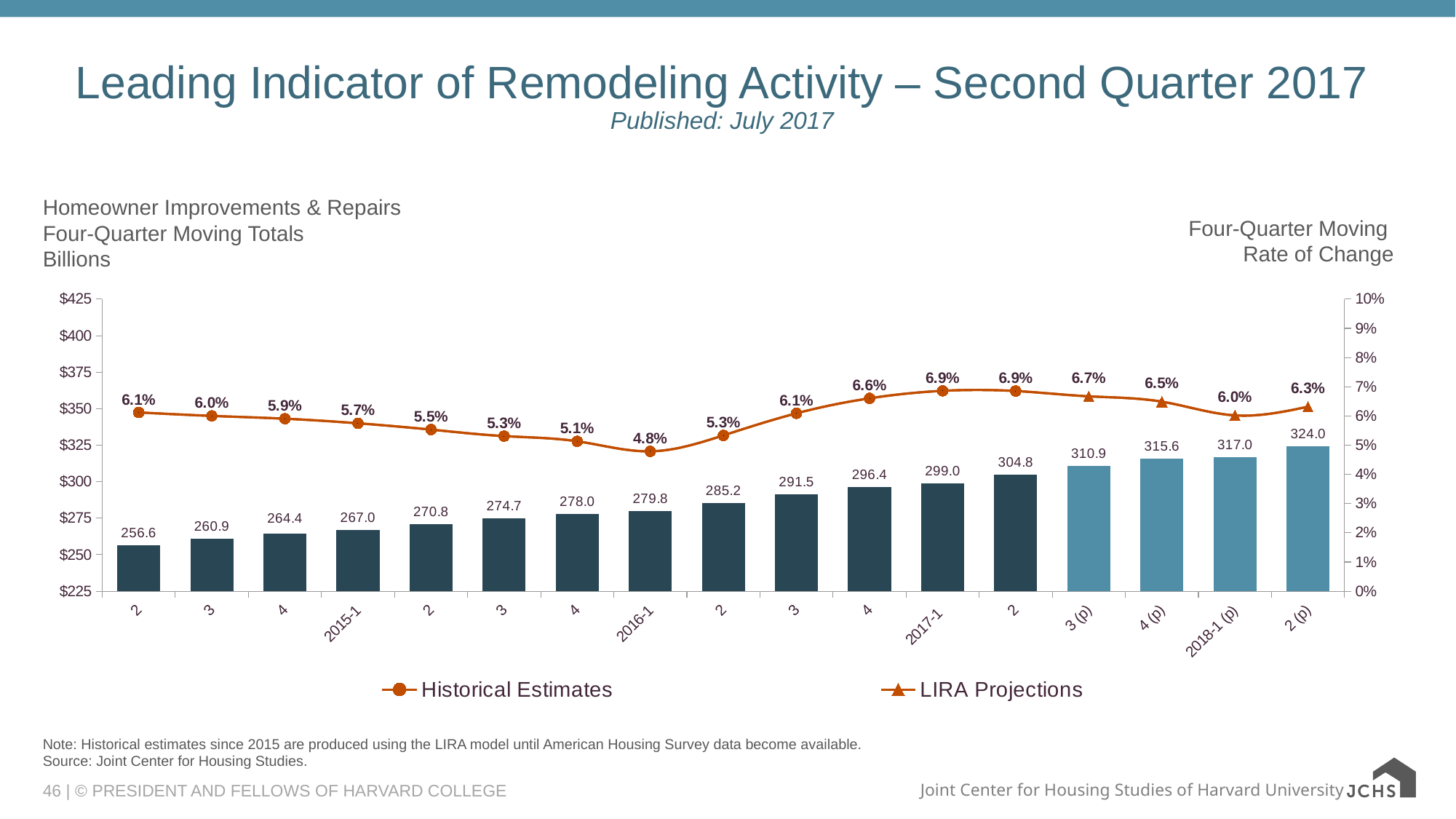
Which period has the highest four-quarter moving total? 2 (p) How many bars are plotted in the chart? 17 What is the title of the slide? Leading Indicator of Remodeling Activity – Second Quarter 2017 Is the rate of change for 2017-1 greater or less than the rate of change for 2016-1? Greater Do the four-quarter moving totals rise or fall from left to right across the chart? Rise What is the four-quarter moving total for 2016-1? 279.8 What is the four-quarter moving rate of change for 2017-1? 6.9% What is the difference between the four-quarter moving totals for 2 (p) and 2018-1 (p)? 7.0 Which period has the lowest four-quarter moving rate of change? 2016-1 What is the projected four-quarter moving total for 2018-1 (p)? 317.0 What kind of chart is shown on the slide? Combination bar and line chart How many series does the legend list? 2